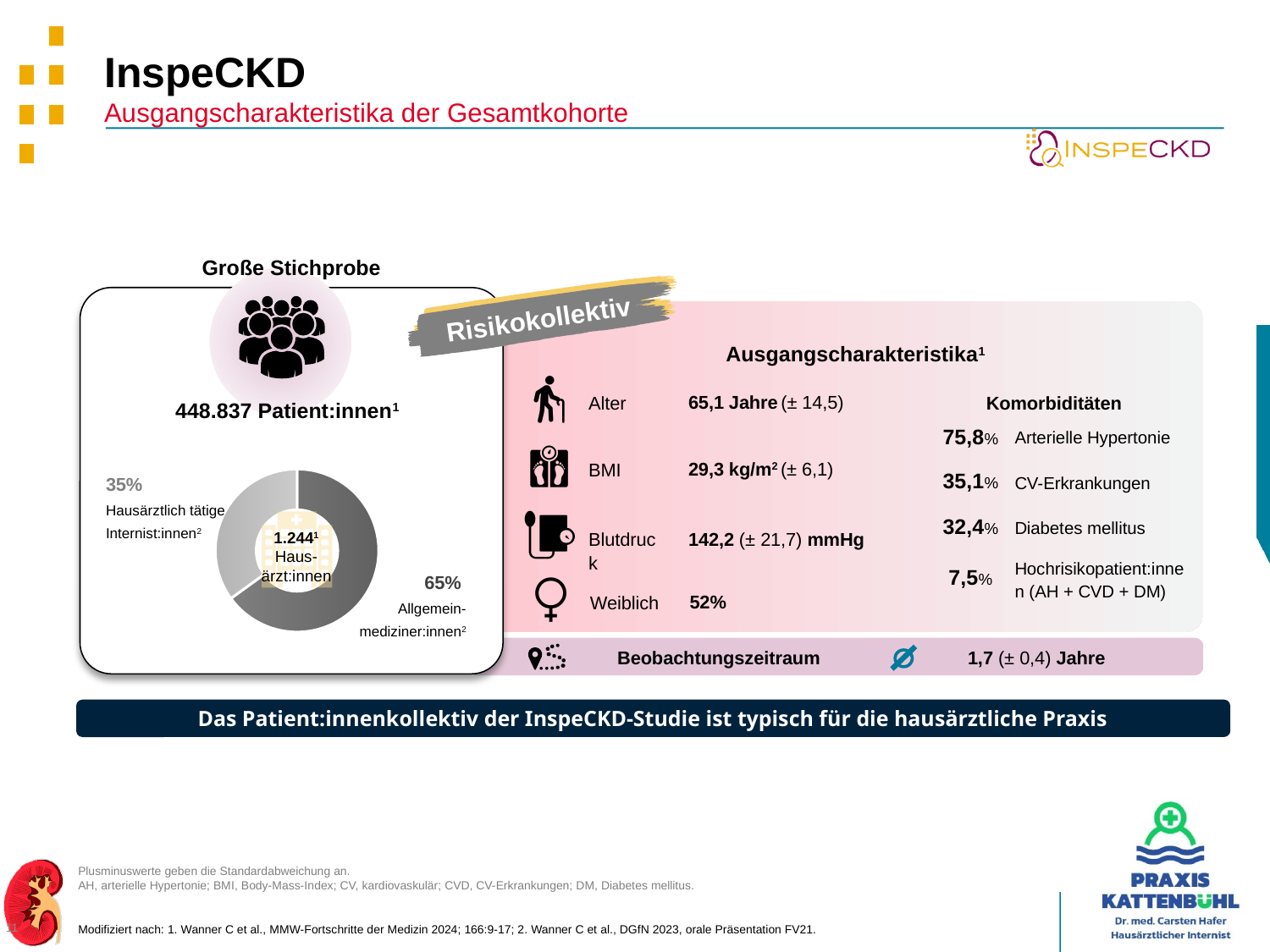
Which group has the smallest share in the donut chart? Hausärztlich tätige Internist:innen In the donut chart, what share is labelled for Allgemeinmediziner:innen? 65% Which group has the larger share in the donut chart, Allgemeinmediziner:innen or Hausärztlich tätige Internist:innen? Allgemeinmediziner:innen What kind of chart is shown on the left of the slide under "Große Stichprobe"? Donut (pie) chart In the donut chart, what share is labelled for Hausärztlich tätige Internist:innen? 35% What is the difference in percentage points between the two slices of the donut chart? 30 percentage points What is the total of the two percentages shown in the donut chart? 100% What heading appears above the donut chart section on the left? Große Stichprobe Which group has the largest share in the donut chart? Allgemeinmediziner:innen What number is printed in the centre of the donut chart? 1.244 How many slices does the donut chart have? 2